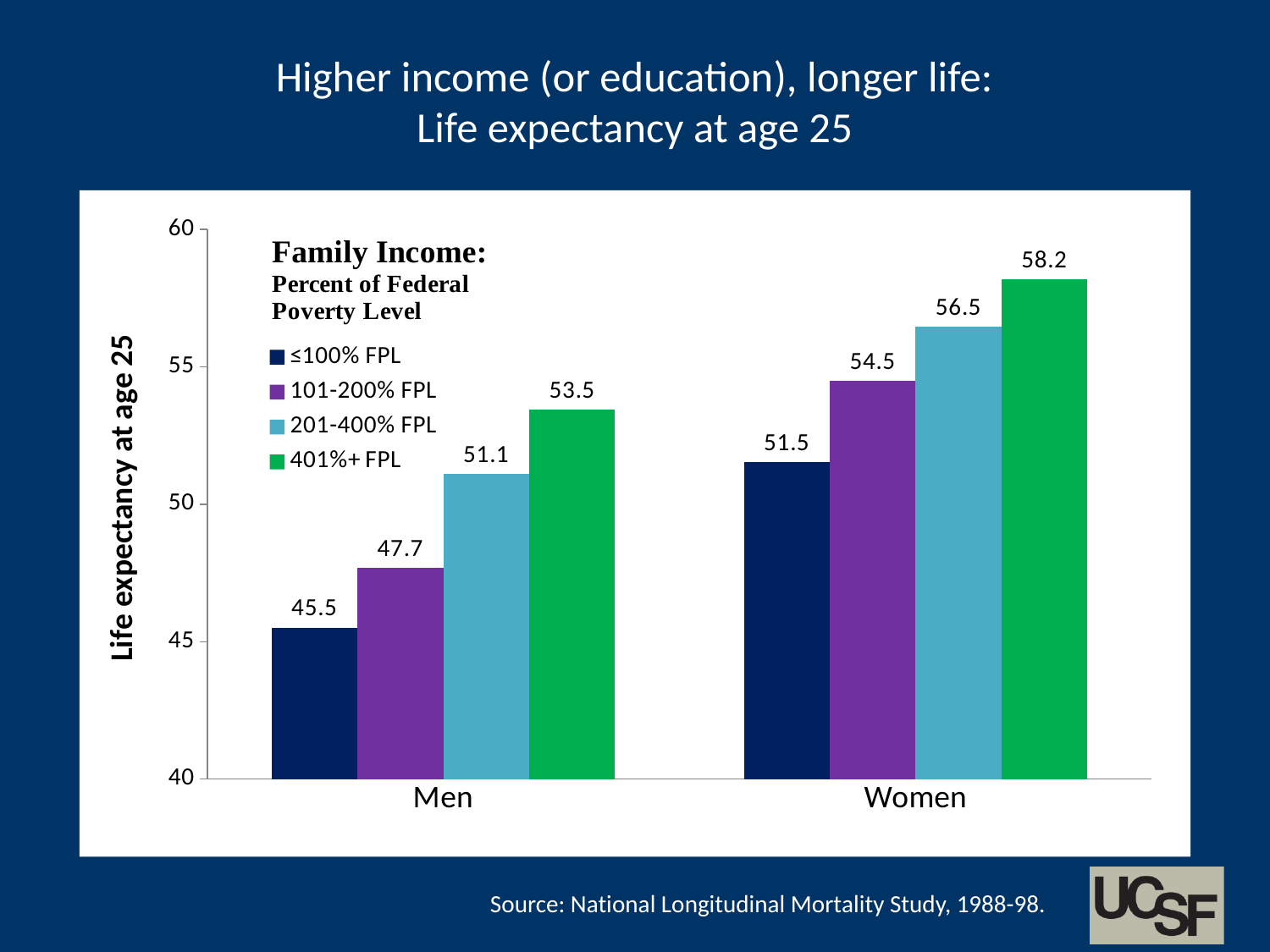
What is the label of the vertical axis? Life expectancy at age 25 What is the difference in life expectancy between women at 401%+ FPL and women at ≤100% FPL? 6.7 How many income groups does the legend list? 4 What is the difference in life expectancy between men at 401%+ FPL and men at ≤100% FPL? 8.0 What is the life expectancy at age 25 for men with family income 101-200% FPL? 47.7 What is the life expectancy at age 25 for women with family income 201-400% FPL? 56.5 What is the life expectancy at age 25 for men with family income ≤100% FPL? 45.5 Which income group has the highest life expectancy among women? 401%+ FPL What kind of chart is shown on the slide? Bar chart Which income group has the lowest life expectancy among men? ≤100% FPL What is the life expectancy at age 25 for women with family income 401%+ FPL? 58.2 Which is larger: life expectancy for men at 401%+ FPL or women at ≤100% FPL? Men at 401%+ FPL